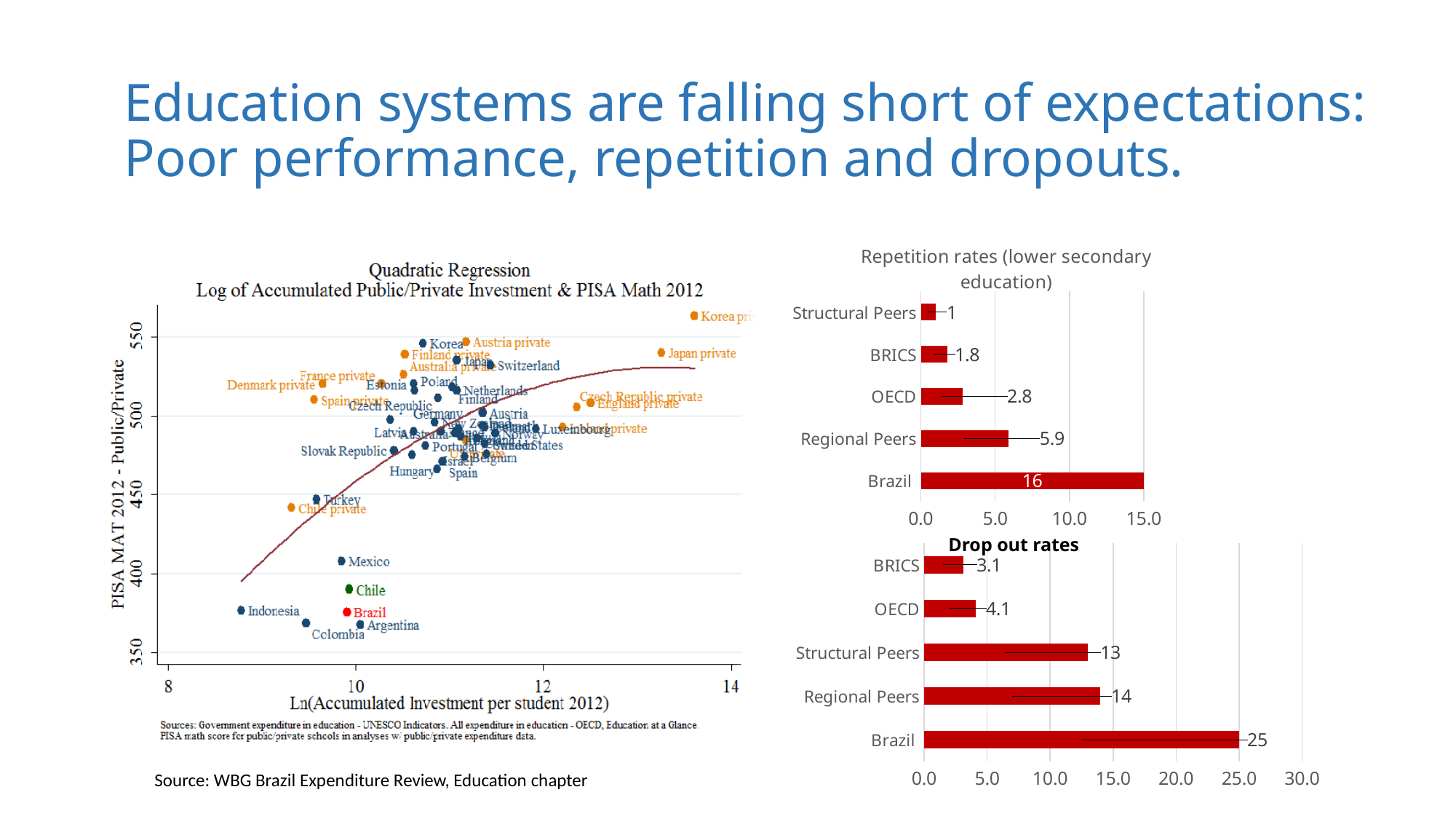
In the Repetition rates (lower secondary education) chart, what is the difference between Brazil and OECD? 13.2 In the Drop out rates chart, what is the value for Structural Peers? 13 In the Quadratic Regression scatter plot on the left, is the PISA Math 2012 score for Brazil greater or less than 400? less In the Drop out rates chart, which is larger, the value for OECD or the value for BRICS? OECD What kind of chart is the Quadratic Regression chart on the left of the slide? Scatter plot In the Drop out rates chart, what is the difference between Regional Peers and Structural Peers? 1 In the Repetition rates (lower secondary education) chart, how many categories are shown? 5 What kind of chart is the Drop out rates chart? Bar chart In the Repetition rates (lower secondary education) chart, what is the value for Brazil? 16 In the Repetition rates (lower secondary education) chart, which category has the lowest value? Structural Peers In the Repetition rates (lower secondary education) chart, what is the value for Regional Peers? 5.9 In the Drop out rates chart, which category has the highest value? Brazil